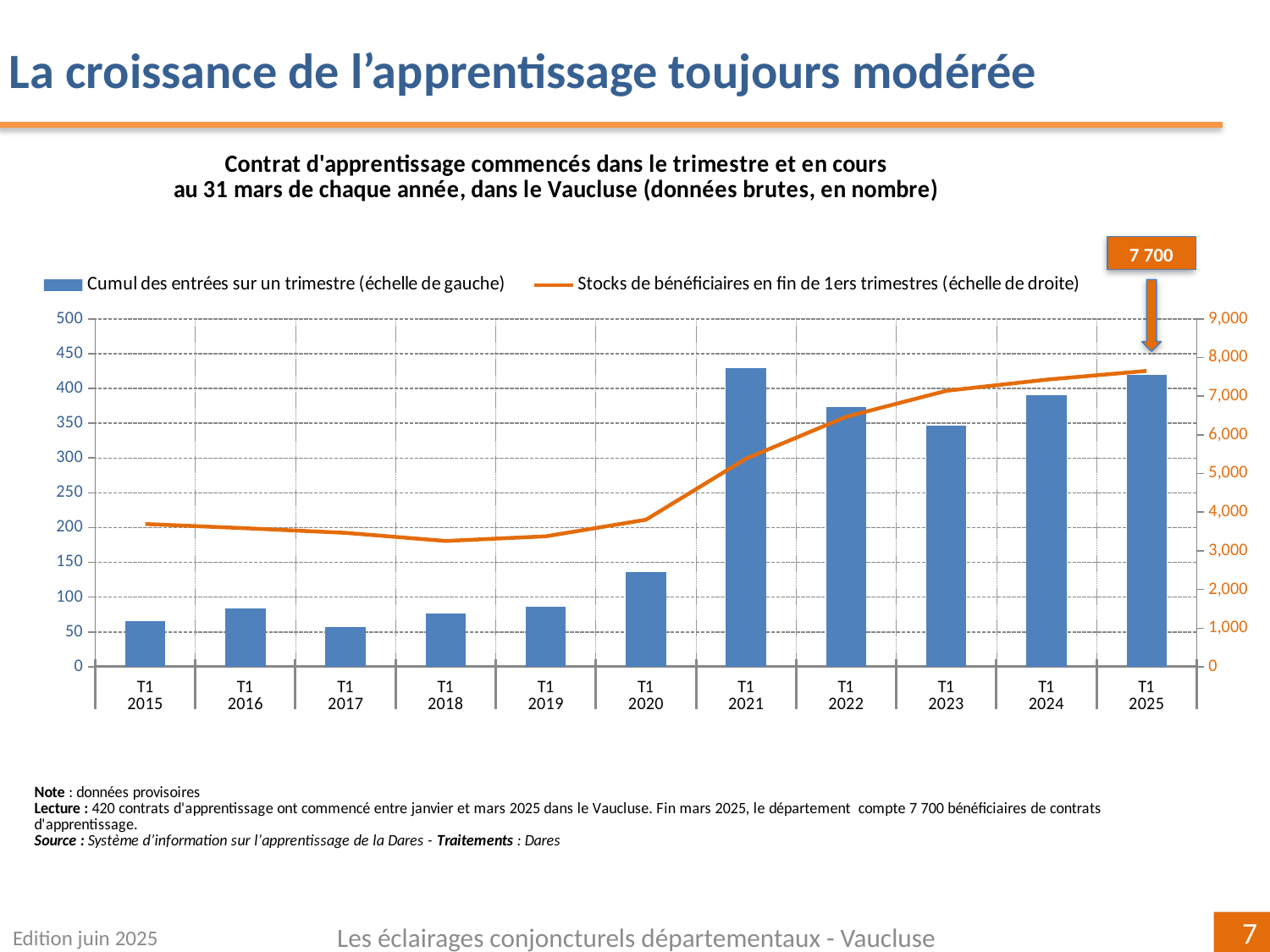
How many quarters are shown on the x axis? 11 Which bar is taller, T1 2021 or T1 2022? T1 2021 According to the slide, how many apprenticeship contracts started between January and March 2025 in the Vaucluse? 420 Which bar is taller, T1 2023 or T1 2024? T1 2024 How many series does the legend list? 2 In which quarter is the bar for 'Cumul des entrées sur un trimestre' the highest? T1 2021 In which quarter is the bar for 'Cumul des entrées sur un trimestre' the lowest? T1 2017 What value does the callout label give for the stock of beneficiaries at the end of T1 2025? 7 700 What kind of chart is shown on the slide? Combined bar and line chart Is the stock of beneficiaries (line, right axis) at T1 2018 greater or less than 4,000? less Is the bar value for T1 2017 greater or less than 100? less Is the bar value for T1 2021 greater or less than 400? greater